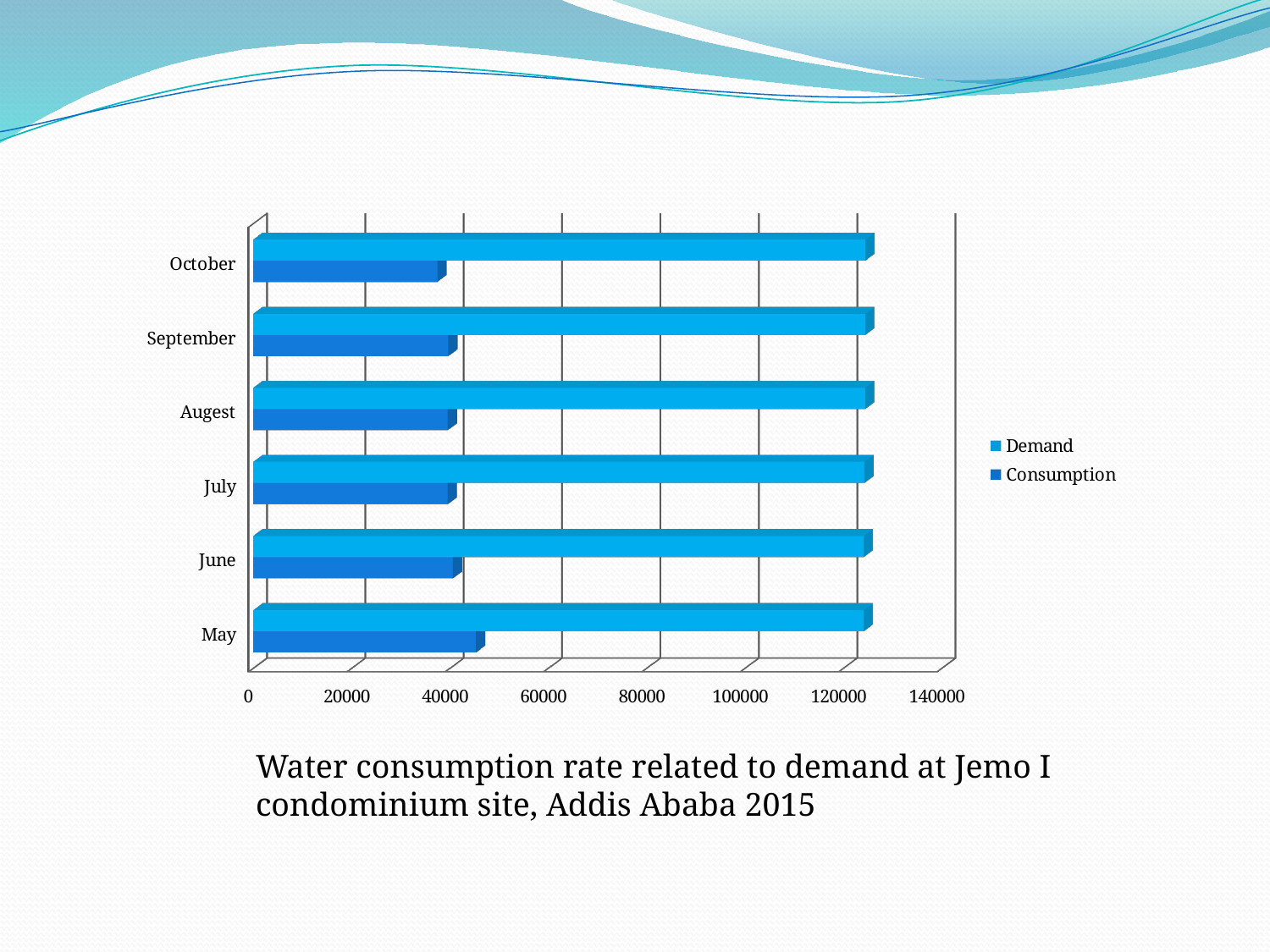
How many months are shown on the chart? 6 What is the caption below the chart? Water consumption rate related to demand at Jemo I condominium site, Addis Ababa 2015 Is the Demand value for October greater or less than 140000? less How many series does the legend list? 2 Is the Consumption value for May greater or less than 60000? less Which is larger for July, Demand or Consumption? Demand What kind of chart is shown on the slide? bar chart Is the Consumption value for October greater or less than 60000? less Which month has the highest Consumption value? May Which series are listed in the legend? Demand and Consumption